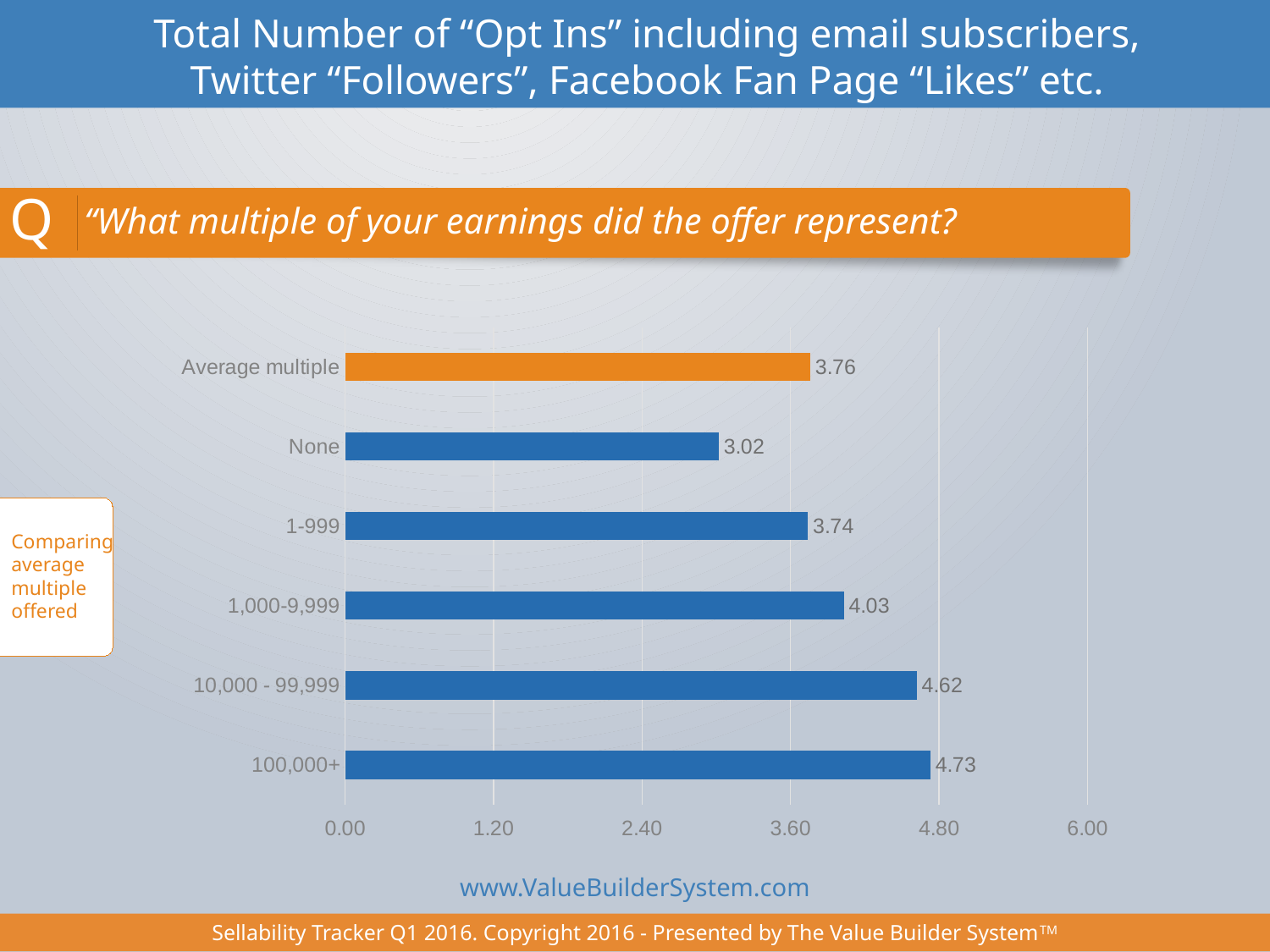
What is the Average multiple shown on the chart? 3.76 Which bar is coloured orange rather than blue? Average multiple Which is larger, the value for 1-999 or the value for None? 1-999 What is the difference between the values for 10,000 - 99,999 and 1,000-9,999? 0.59 What is the value for the 1,000-9,999 category? 4.03 Is the value for 10,000 - 99,999 greater or less than 3.60? greater What is the value for the 100,000+ category? 4.73 What kind of chart is shown on the slide? bar chart How many bars are shown on the chart? 6 Which category has the lowest value? None What is the value for the None category? 3.02 Which category has the highest value? 100,000+